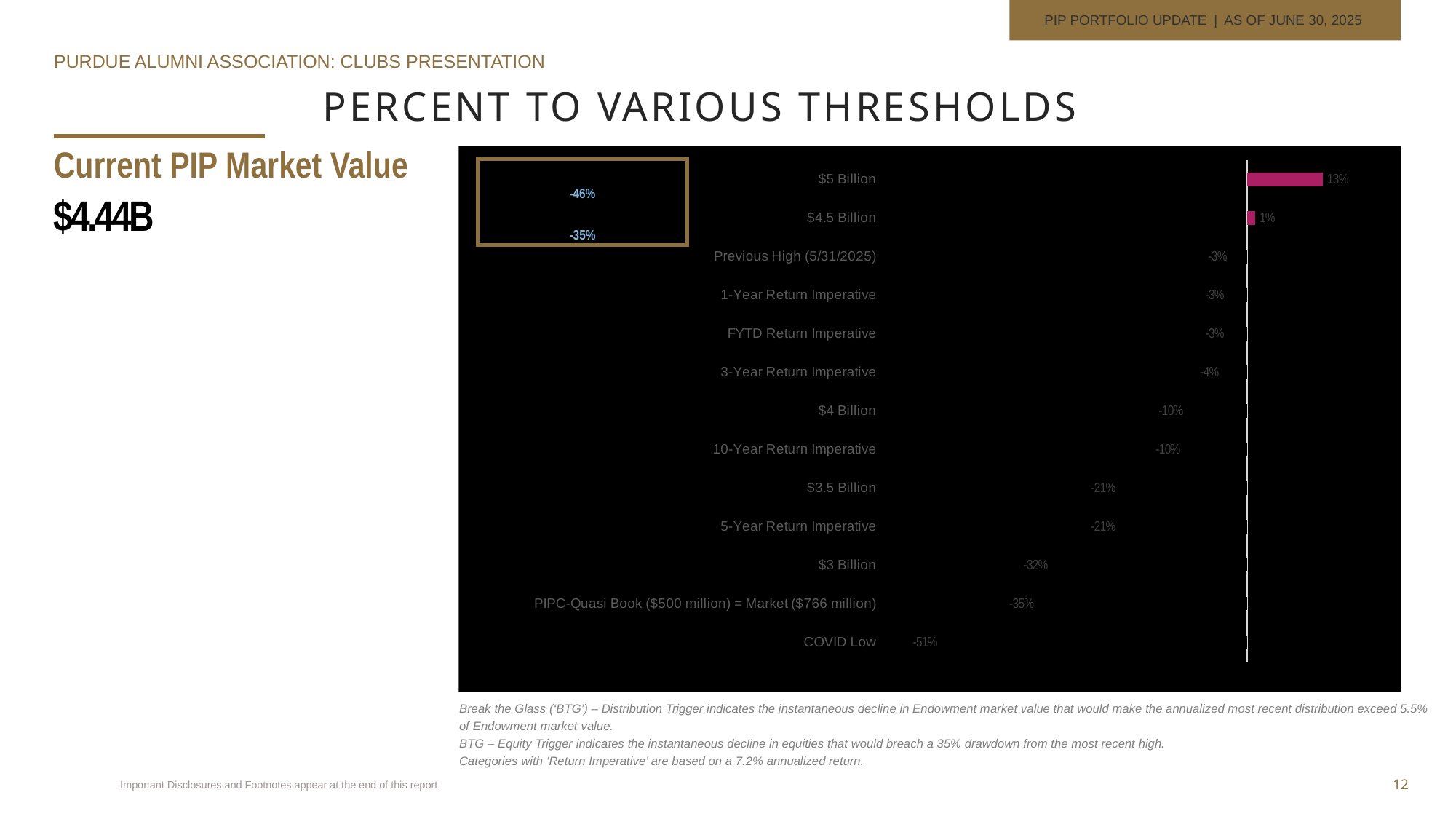
Which category has the lowest value? COVID Low What is the value for 3-Year Return Imperative? -4% How many categories are shown in the chart? 13 What is the title of the chart? Percent to Various Thresholds Which category has the highest value? $5 Billion What is the difference between the values for $5 Billion and $4.5 Billion? 12% Which is larger, the value for $4 Billion or the value for $3.5 Billion? $4 Billion What is the value for COVID Low? -51% What kind of chart is shown on the slide? bar chart What is the value for $5 Billion? 13% What is the value for $4.5 Billion? 1% What is the value for $3 Billion? -32%